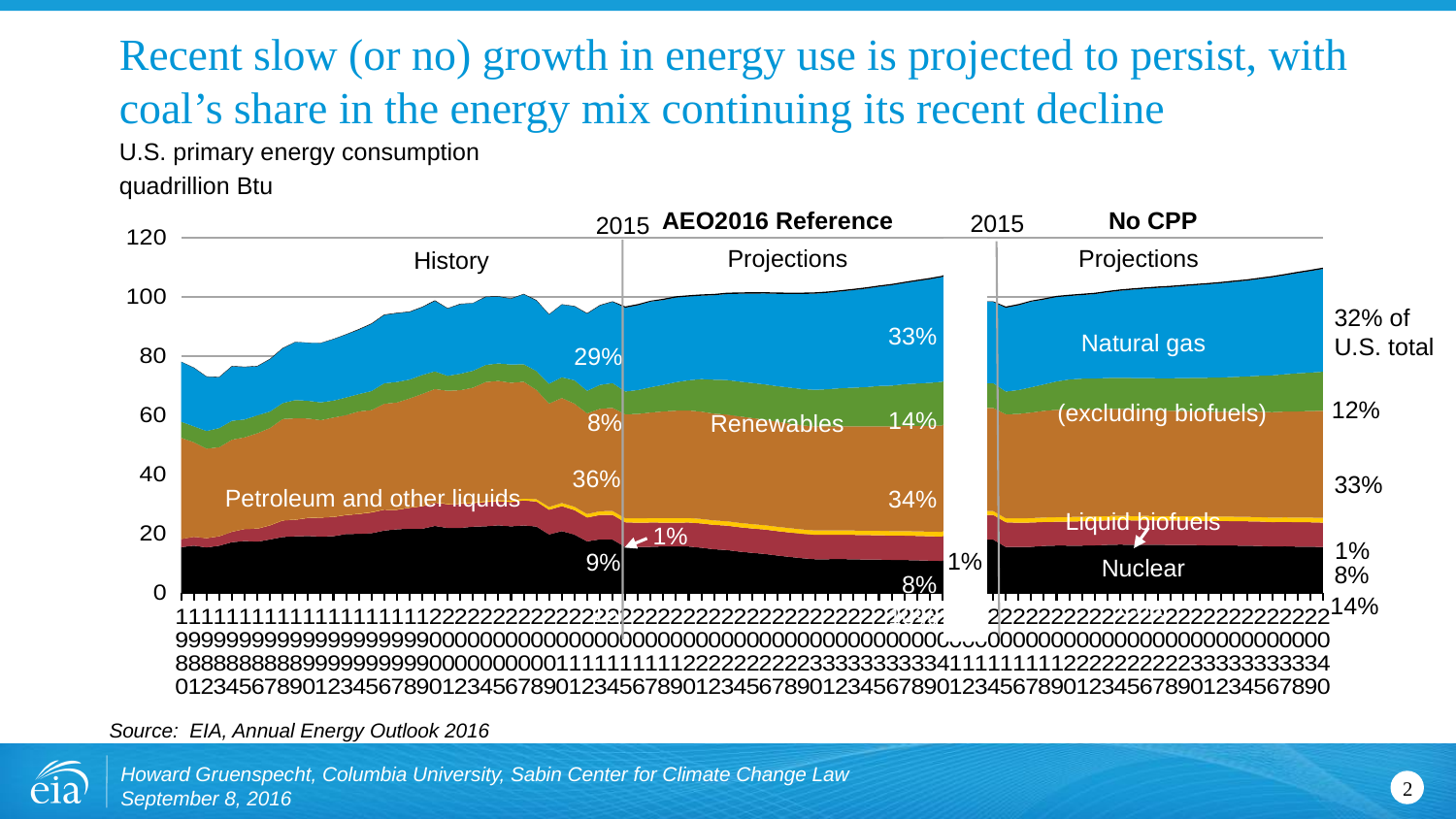
What share do renewables (excluding biofuels) reach at the end of the No CPP projection? 12% In what units is U.S. primary energy consumption measured on the chart? quadrillion Btu What share do petroleum and other liquids have at the end of the AEO2016 Reference projection? 34% Is total U.S. primary energy consumption at the end of the AEO2016 Reference projection greater or less than 100 quadrillion Btu? greater What share do renewables (excluding biofuels) reach at the end of the AEO2016 Reference projection? 14% What kind of chart is shown on the slide? Stacked area chart By how many percentage points does the natural gas share rise from 2015 (29%) to the end of the AEO2016 Reference projection (33%)? 4 percentage points What share does natural gas reach at the end of the AEO2016 Reference projection? 33% What share of U.S. primary energy consumption does natural gas have in 2015, according to the chart label? 29% Which projection ends with a larger renewables (excluding biofuels) share: AEO2016 Reference or No CPP? AEO2016 Reference What is the source cited for the chart? EIA, Annual Energy Outlook 2016 What share of U.S. primary energy consumption do petroleum and other liquids have in 2015? 36%